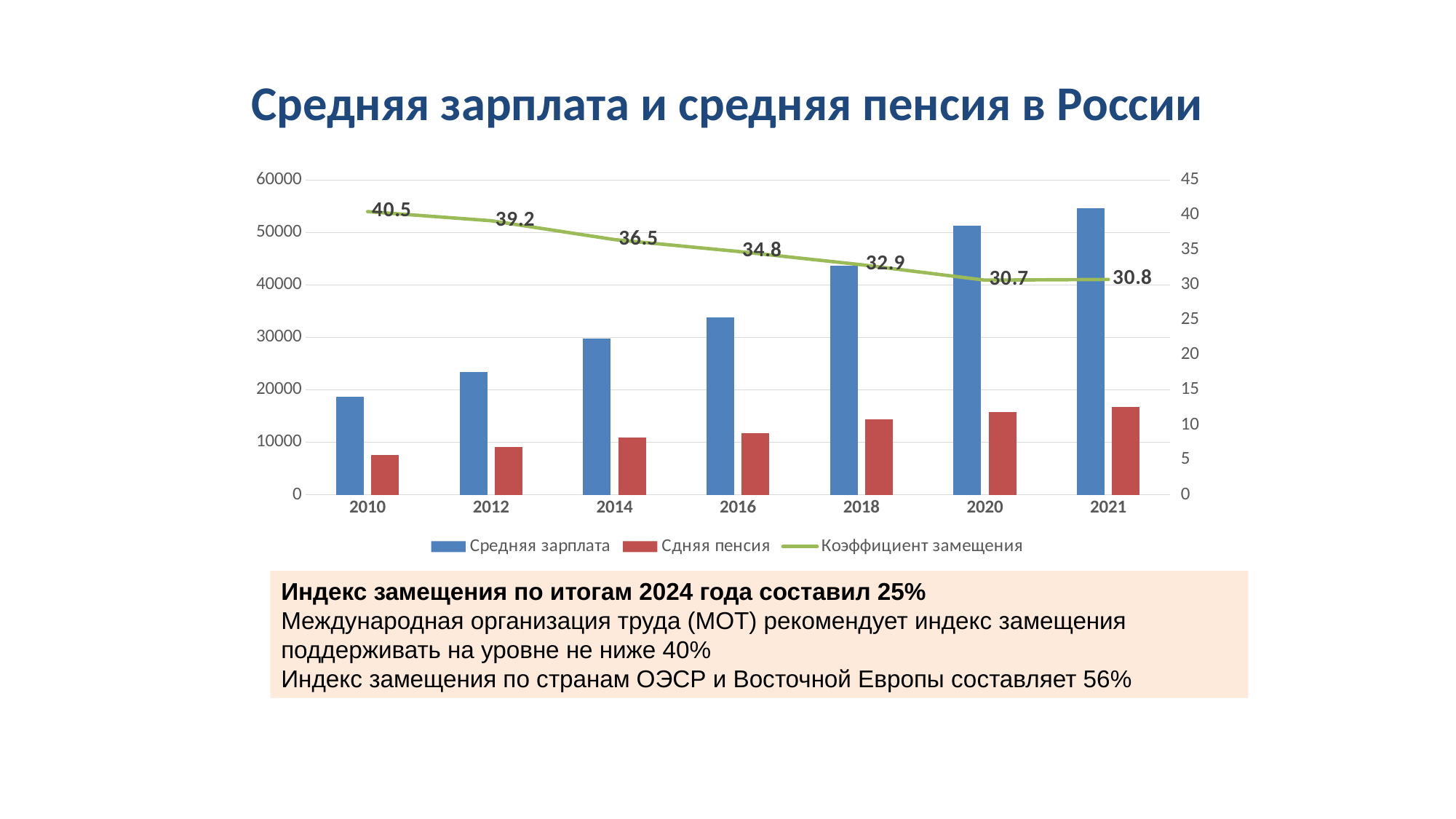
What is the value of the replacement coefficient (Коэффициент замещения) for 2021? 30.8 Which is larger in 2018: the average salary (Средняя зарплата) or the average pension (Сдняя пенсия)? Средняя зарплата What is the value of the replacement coefficient (Коэффициент замещения) for 2016? 34.8 In which year is the replacement coefficient (Коэффициент замещения) the highest? 2010 What is the difference between the replacement coefficient in 2010 and in 2021? 9.7 Does the replacement coefficient (Коэффициент замещения) generally rise or fall from 2010 to 2021? fall In which year is the replacement coefficient (Коэффициент замещения) the lowest? 2020 How many years are shown on the x axis of the chart? 7 How many series does the chart legend list? 3 Is the average pension (Сдняя пенсия) for 2010 greater or less than 10000? less Is the average salary (Средняя зарплата) for 2021 greater or less than 50000? greater What is the value of the replacement coefficient (Коэффициент замещения) for 2010? 40.5